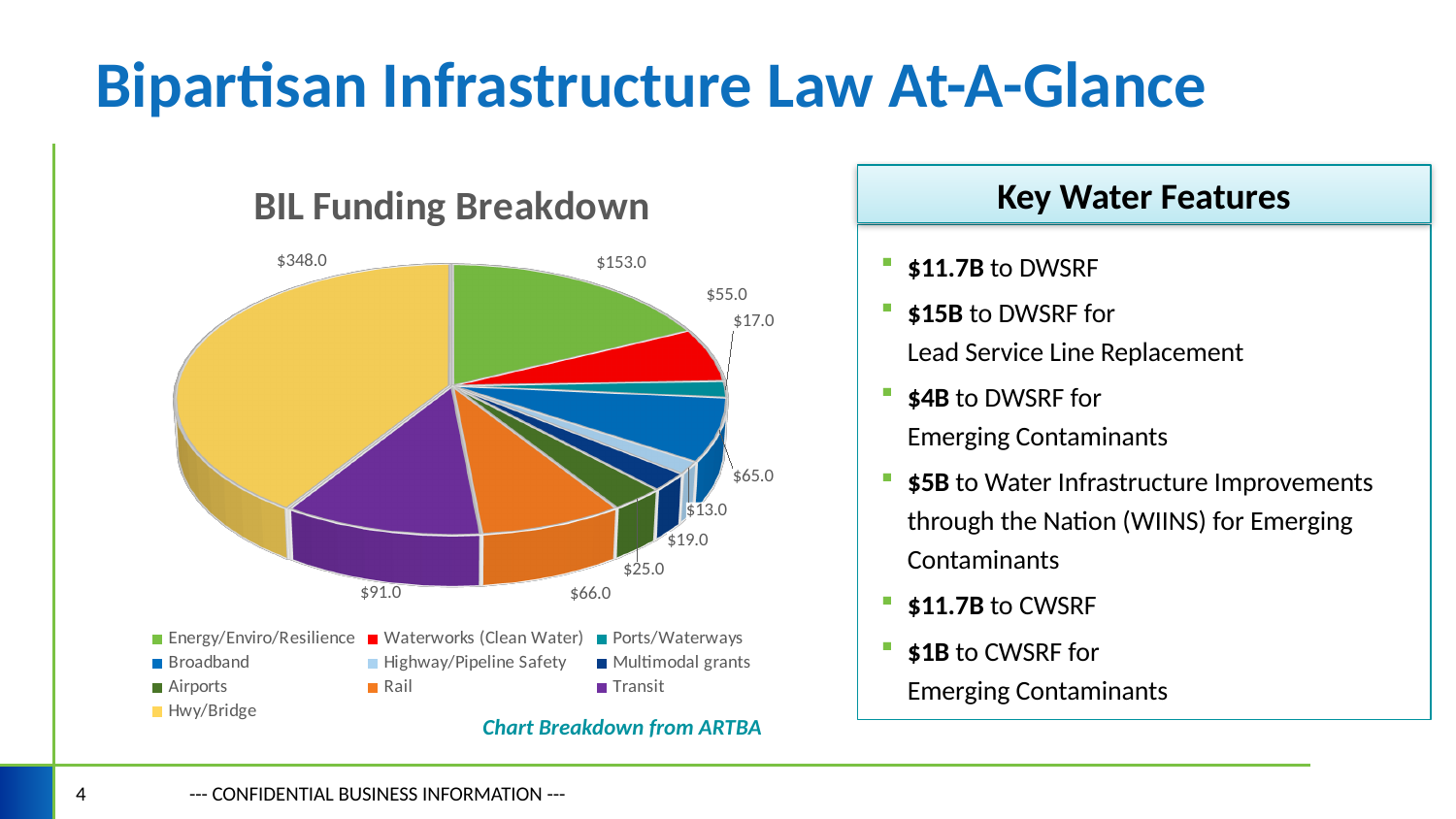
How many slices does the BIL Funding Breakdown pie chart have? 10 What is the value shown for Hwy/Bridge in the BIL Funding Breakdown? $348.0 What is the value shown for Waterworks (Clean Water) in the BIL Funding Breakdown? $55.0 What is the value shown for Broadband in the BIL Funding Breakdown? $65.0 What is the value shown for Energy/Enviro/Resilience in the BIL Funding Breakdown? $153.0 What type of chart is the BIL Funding Breakdown? Pie chart What is the difference between the Hwy/Bridge value and the Energy/Enviro/Resilience value in the BIL Funding Breakdown? $195.0 Which category receives the largest share of BIL funding in the pie chart? Hwy/Bridge Which category receives the smallest share of BIL funding in the pie chart? Highway/Pipeline Safety According to the note under the pie chart, where does the chart breakdown come from? ARTBA In the BIL Funding Breakdown, which is larger: Rail or Airports? Rail What is the value shown for Transit in the BIL Funding Breakdown? $91.0